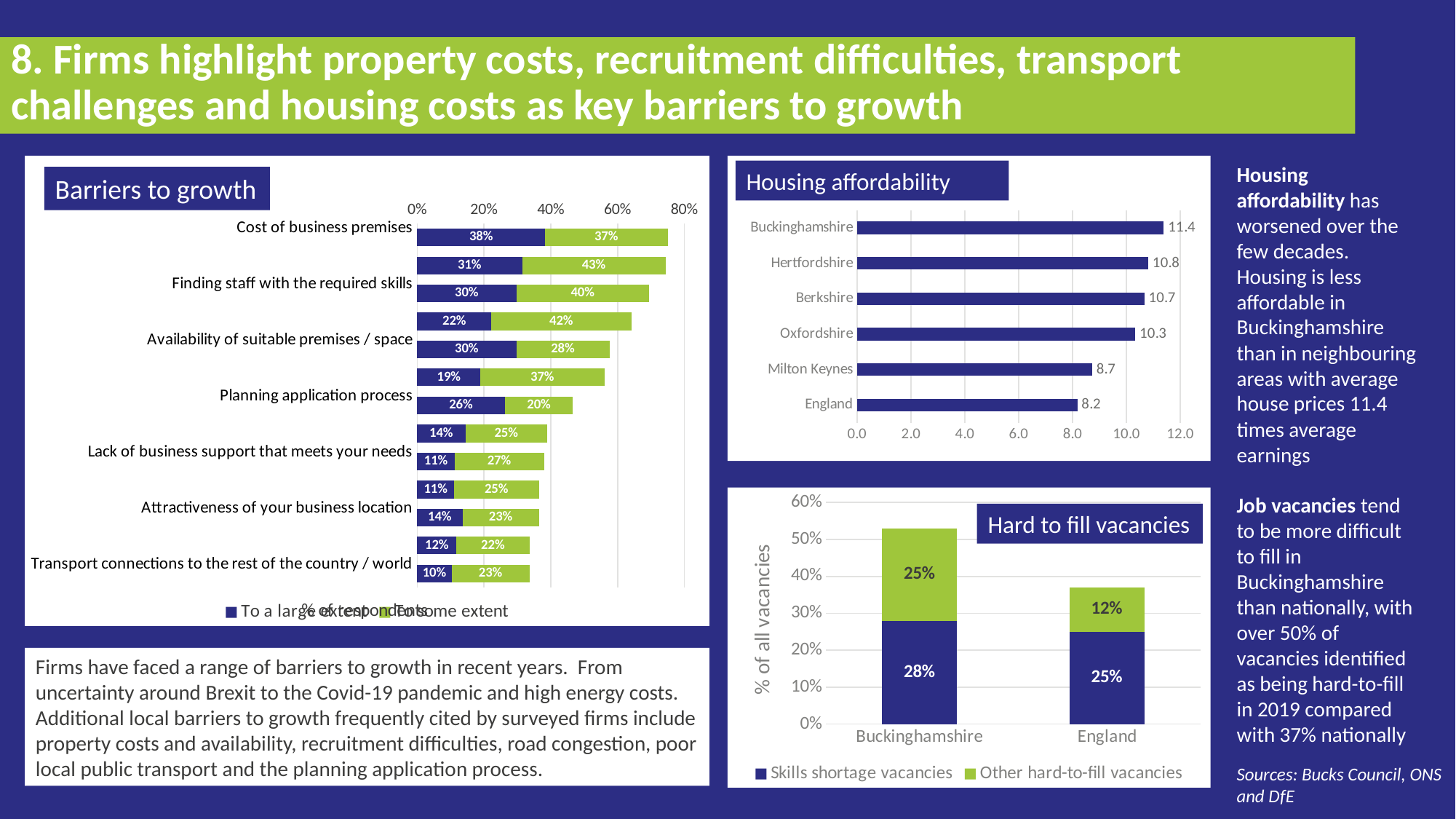
What kind of chart is the Barriers to growth chart? Stacked bar chart In the Hard to fill vacancies chart, what is the value for Other hard-to-fill vacancies in England? 12% In the Hard to fill vacancies chart, how many series does the legend list? 2 In the Housing affordability chart, is the value for Hertfordshire greater or less than Oxfordshire? greater In the Housing affordability chart, what is the difference between Buckinghamshire and England? 3.2 In the Housing affordability chart, how many areas are shown? 6 In the Hard to fill vacancies chart, what is the value for Skills shortage vacancies in Buckinghamshire? 28% In the Hard to fill vacancies chart, what is the total of the stacked bar for Buckinghamshire? 53% In the Housing affordability chart, what is the value for Milton Keynes? 8.7 In the Housing affordability chart, which area has the highest value? Buckinghamshire In the Housing affordability chart, what is the value for Buckinghamshire? 11.4 In the Housing affordability chart, which area has the lowest value? England